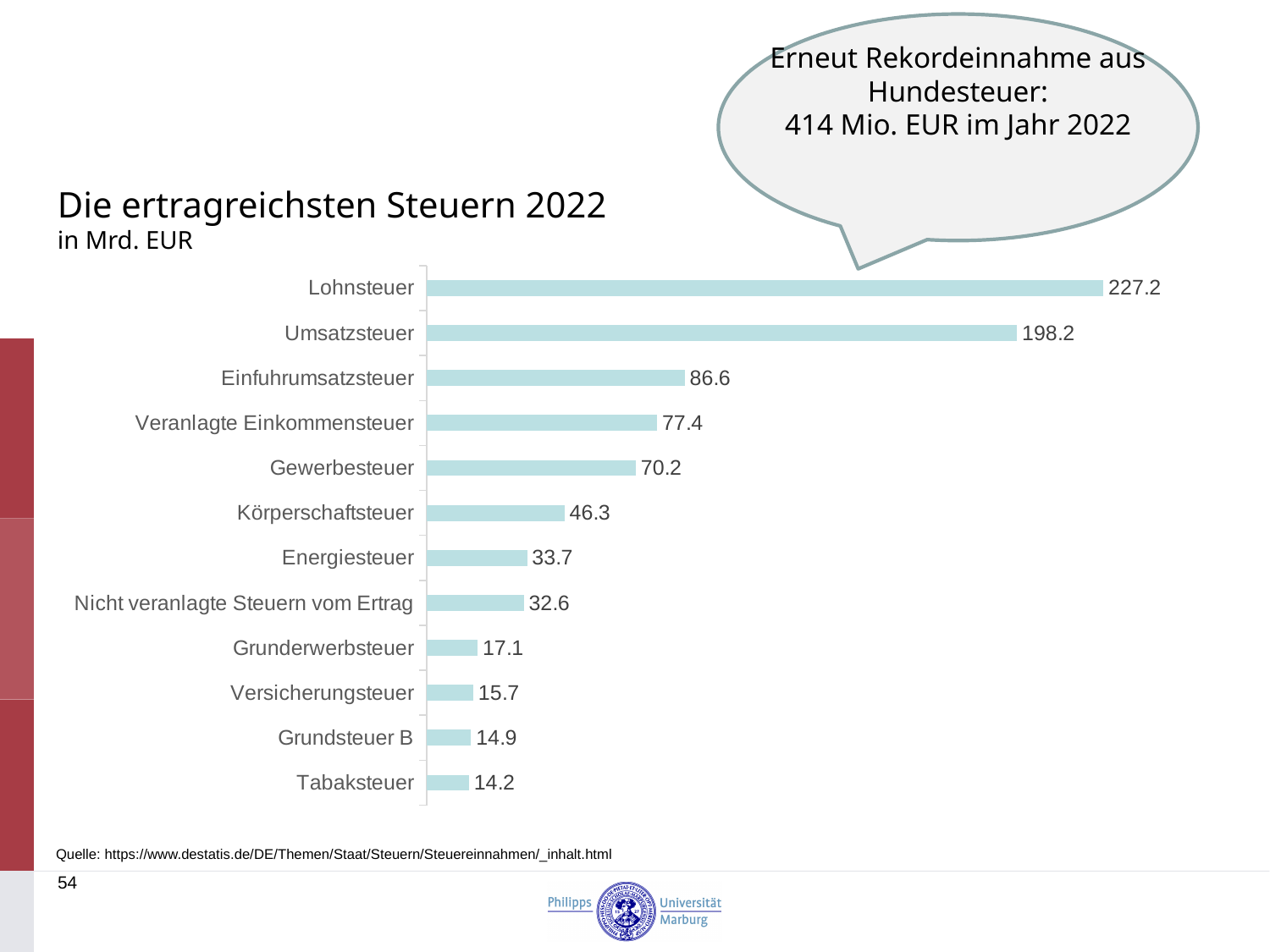
How many categories are shown in the chart? 12 Which category has the highest value? Lohnsteuer What is the difference between Lohnsteuer and Umsatzsteuer? 29.0 What is the value for Grunderwerbsteuer? 17.1 What kind of chart is shown on the slide? Bar chart What is the value for Lohnsteuer? 227.2 What is the title of the chart? Die ertragreichsten Steuern 2022 What is the value for Gewerbesteuer? 70.2 Which category has the lowest value? Tabaksteuer Which is larger, Energiesteuer or Körperschaftsteuer? Körperschaftsteuer What is the difference between Einfuhrumsatzsteuer and Veranlagte Einkommensteuer? 9.2 Which is larger, Versicherungsteuer or Grundsteuer B? Versicherungsteuer